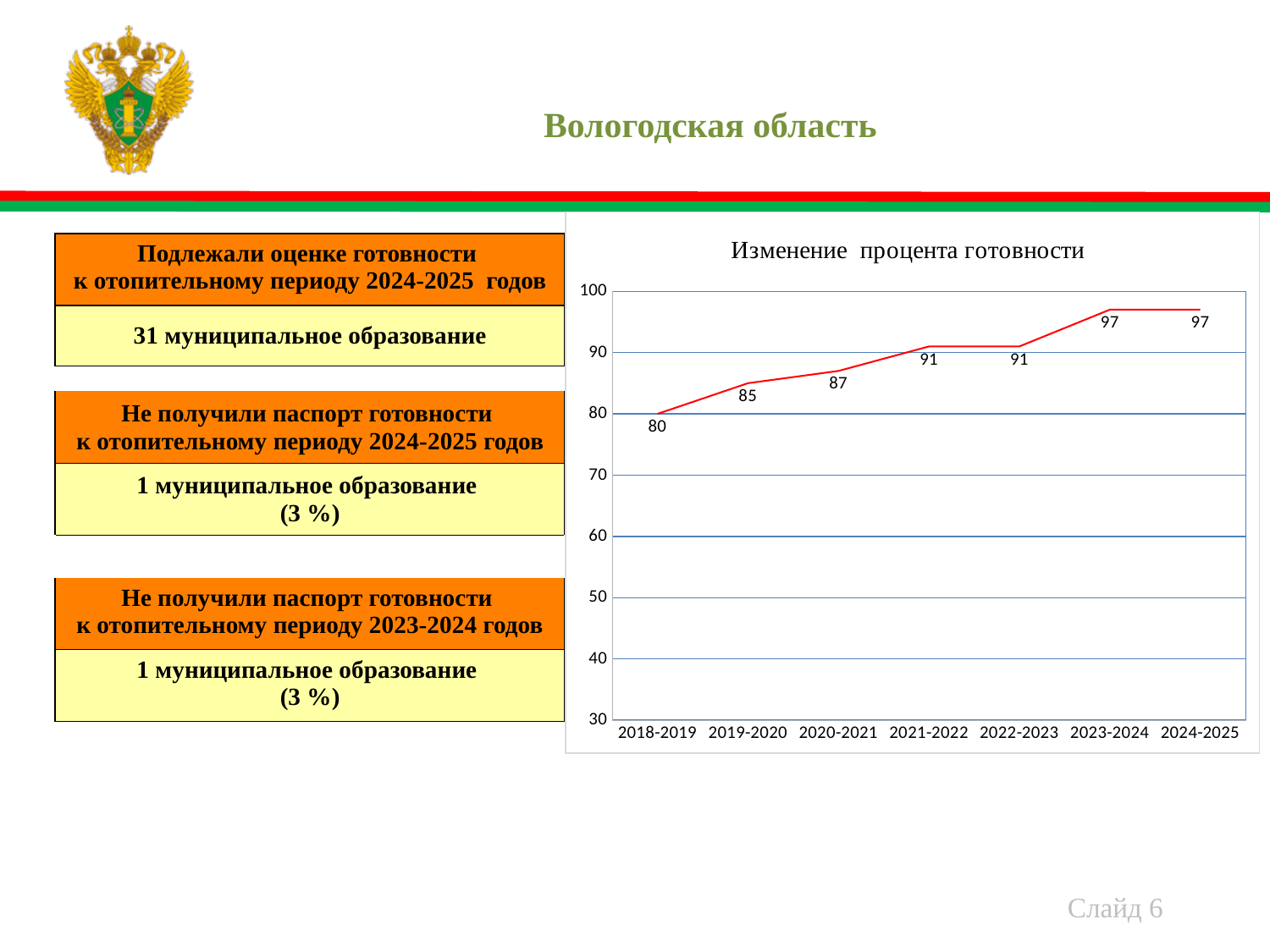
What is the title of the chart? Изменение процента готовности What kind of chart is this? line chart What is the value for 2020-2021? 87 How many periods are shown on the x axis? 7 What is the difference between the values for 2021-2022 and 2019-2020? 6 Do the values generally rise or fall from 2018-2019 to 2024-2025? rise Which period has the lowest value? 2018-2019 What is the value for 2022-2023? 91 What is the difference between the values for 2024-2025 and 2018-2019? 17 Which is larger, the value for 2019-2020 or the value for 2020-2021? 2020-2021 What is the value for 2018-2019? 80 Is the value for 2023-2024 greater or less than 90? greater